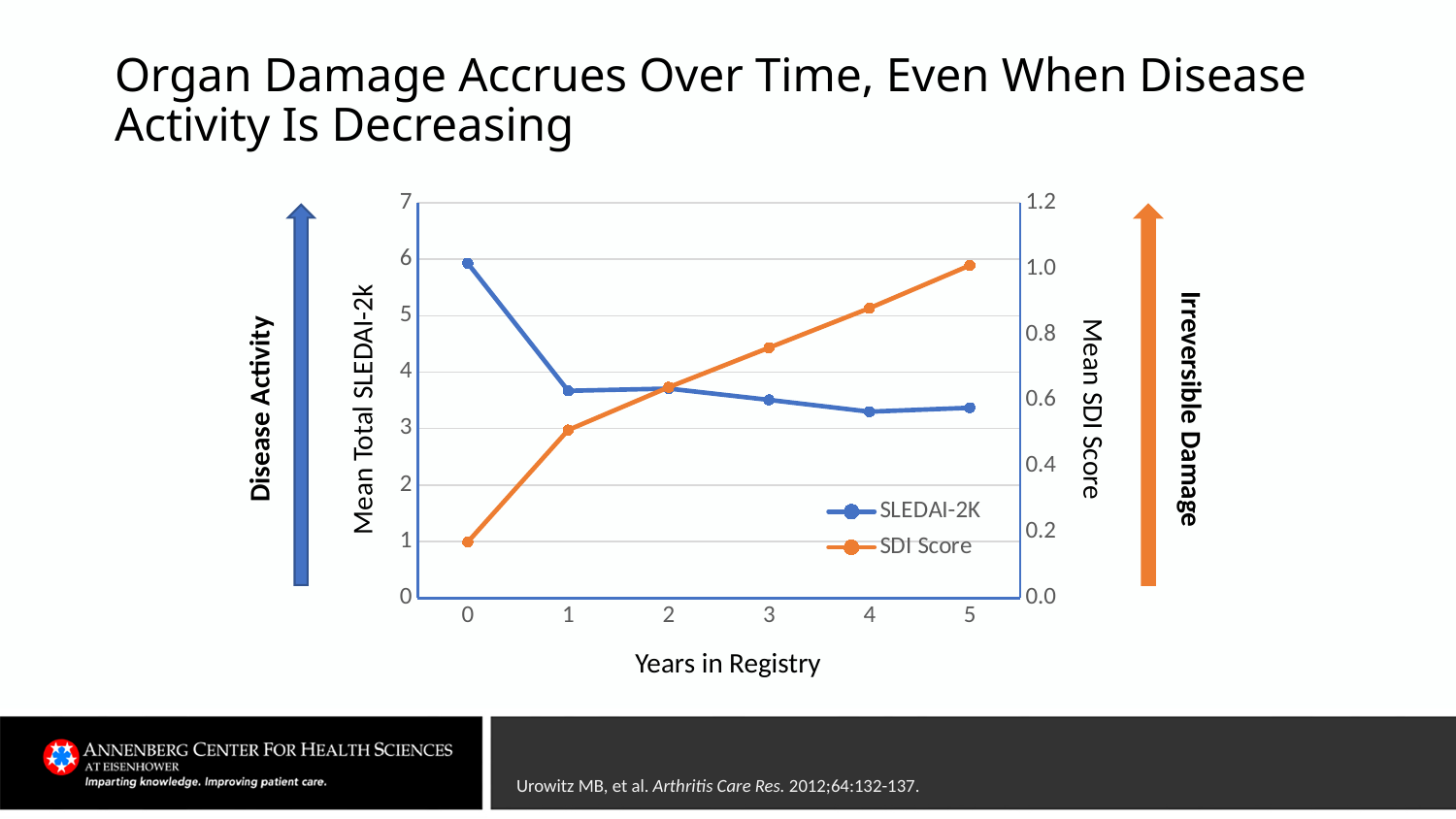
At which year in registry is the SLEDAI-2K value highest? 0 Is the SDI Score at year 5 greater or less than 0.8? greater What is the title of the x axis of the chart? Years in Registry Does the SLEDAI-2K series rise or fall as years in registry increase? fall Does the SDI Score series rise or fall as years in registry increase? rise At which year in registry is the SDI Score lowest? 0 How many points are plotted for the SLEDAI-2K series? 6 Is the SLEDAI-2K value at year 5 greater or less than 4? less At which year in registry is the SDI Score highest? 5 What kind of chart is shown on the slide? line chart How many series does the chart's legend list? 2 Is the SLEDAI-2K value at year 0 greater or less than 5? greater